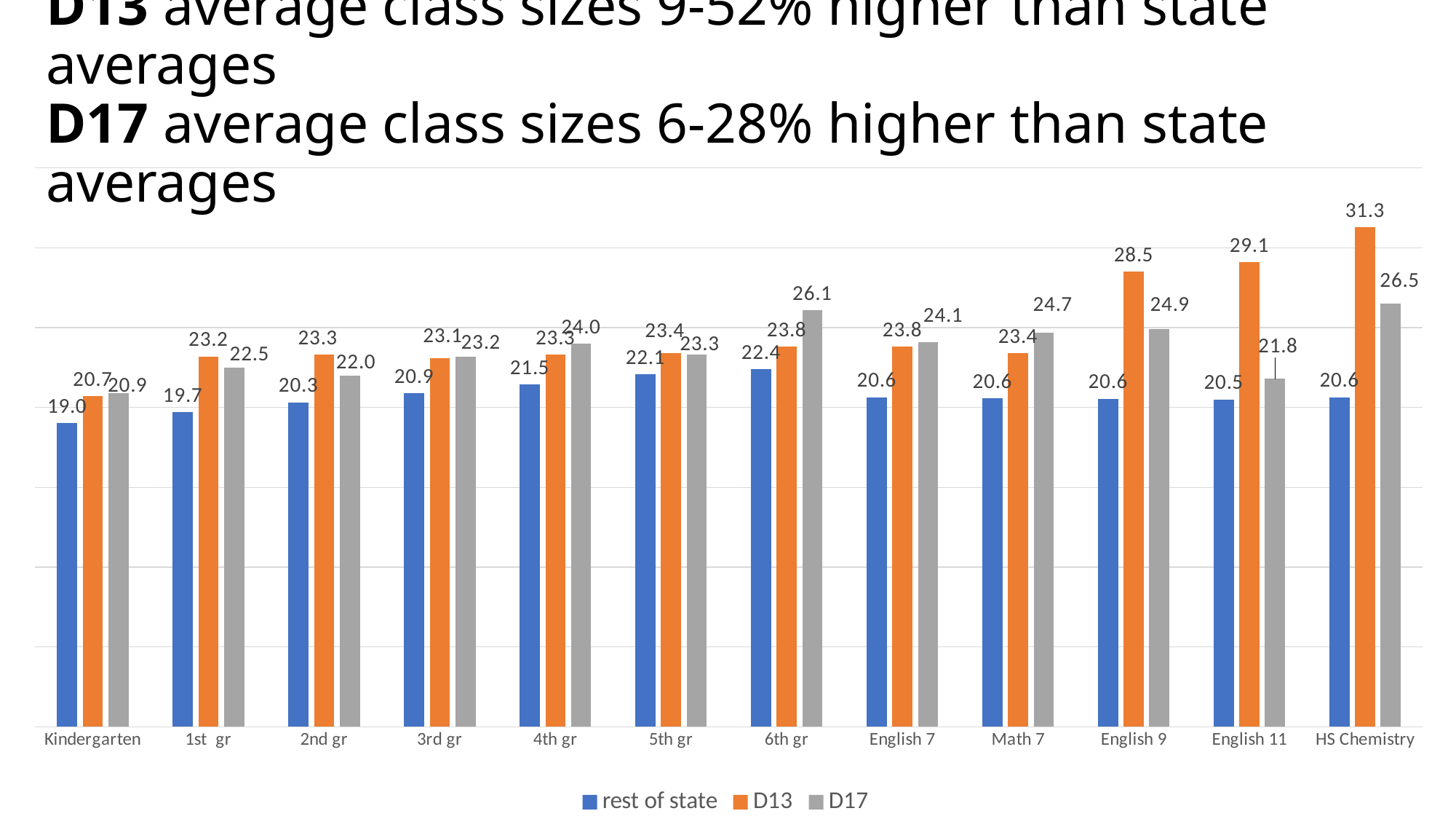
For 6th gr, which is larger, the D13 value or the D17 value? D17 Which category has the lowest rest of state value? Kindergarten What is the rest of state value for Kindergarten? 19.0 Which series is shown in orange? D13 How many categories are shown on the x axis? 12 For English 9, which is larger, the D13 value or the D17 value? D13 How many series does the legend list? 3 What kind of chart is shown on the slide? bar chart What is the D17 value for 6th gr? 26.1 What is the difference between the D13 and rest of state values for English 11? 8.6 What is the D13 average class size for HS Chemistry? 31.3 Which category has the highest D13 value? HS Chemistry